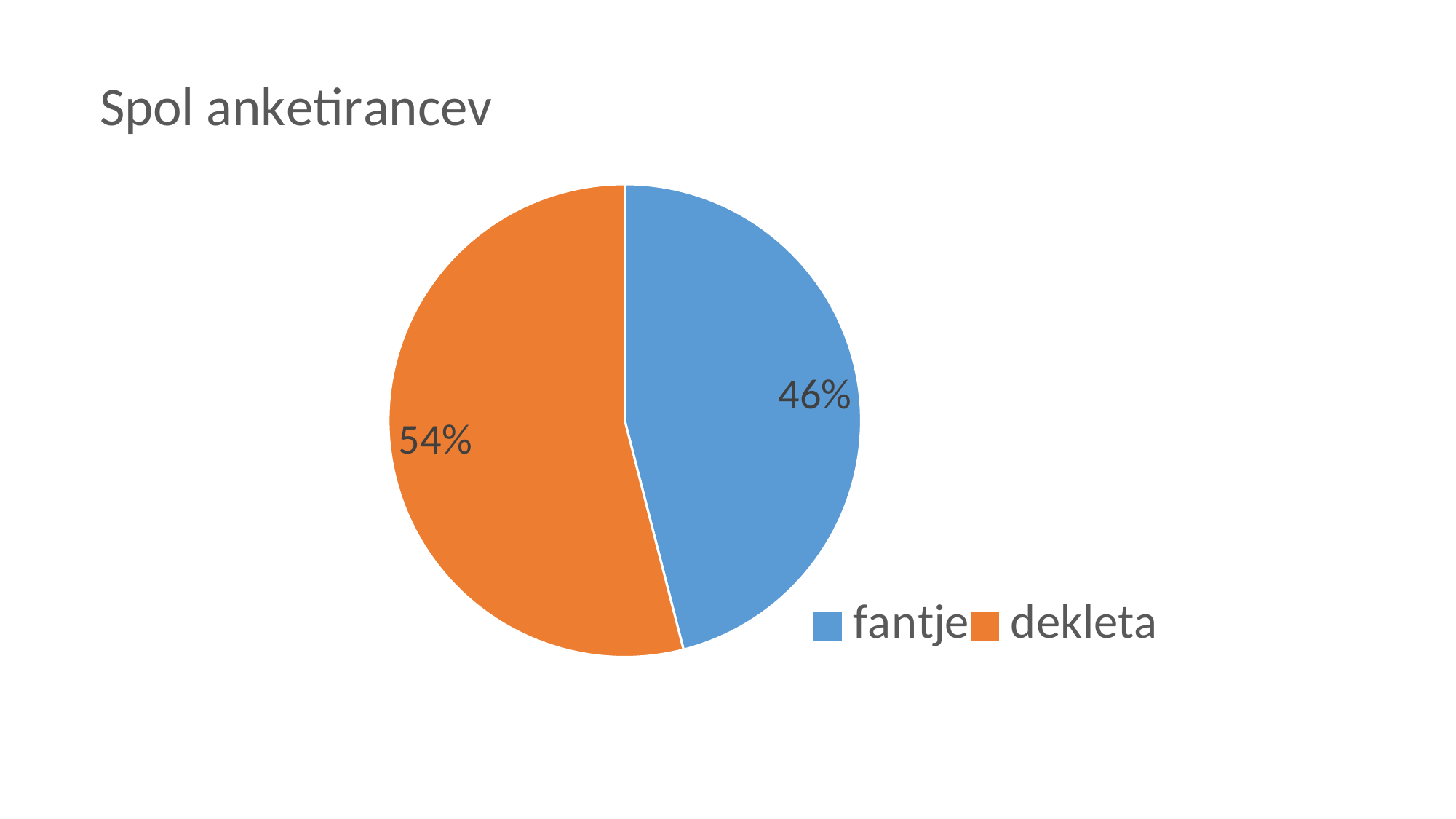
What share of the pie is dekleta? 54% Which is larger, the share for fantje or the share for dekleta? dekleta What is the difference in percentage points between dekleta and fantje? 8 What kind of chart is shown on the slide? pie chart How many entries does the legend list? 2 How many slices does the pie chart have? 2 What is the title of the chart? Spol anketirancev What share of the pie is fantje? 46% Which category has the largest slice? dekleta Which category has the smallest slice? fantje What colour is the slice for fantje? blue